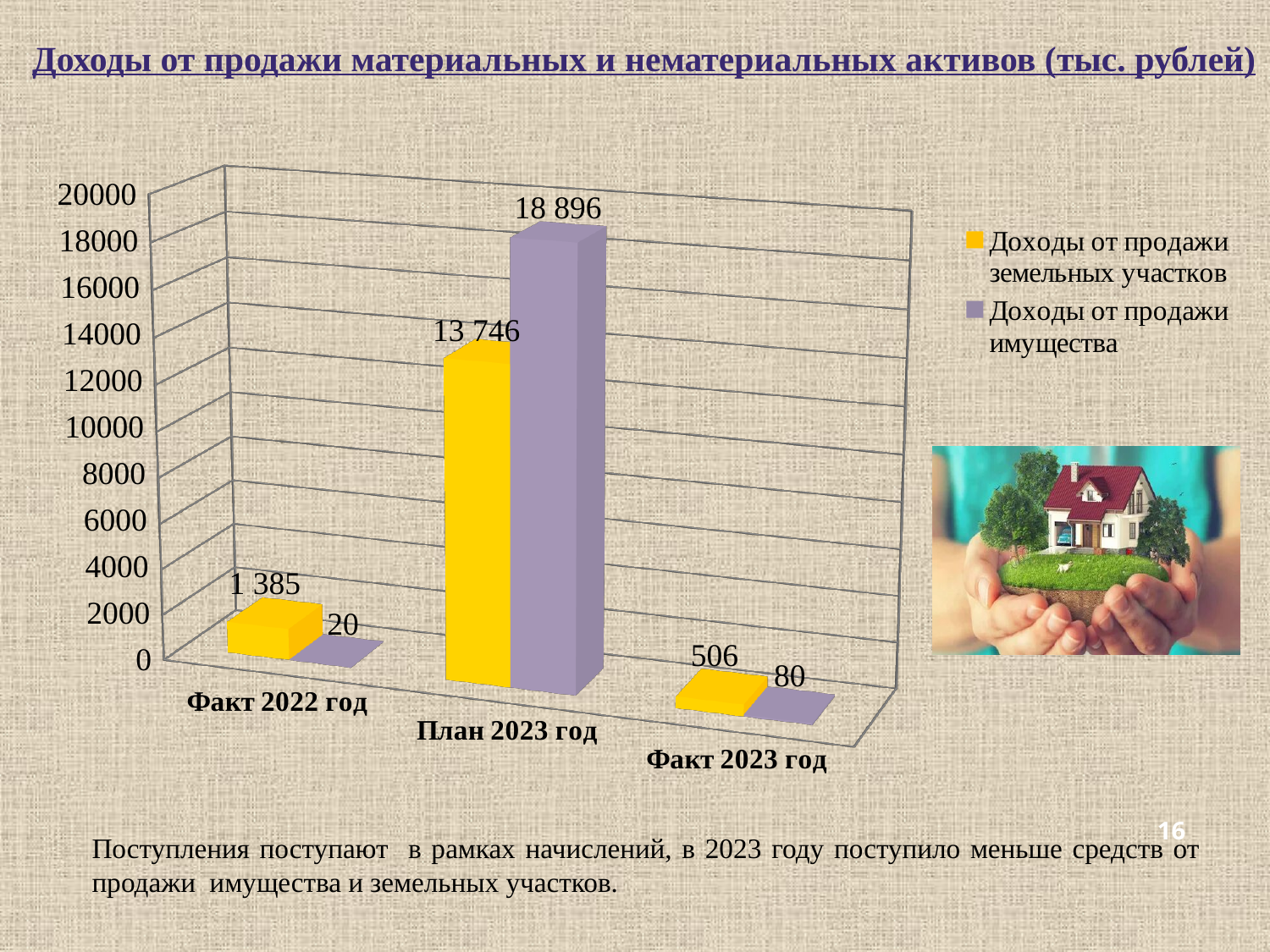
Which category has the lowest value for Доходы от продажи имущества? Факт 2022 год What is the value for Доходы от продажи имущества in План 2023 год? 18 896 What is the value for Доходы от продажи земельных участков in План 2023 год? 13 746 How many categories are shown on the x axis? 3 Which is larger in Факт 2023 год: Доходы от продажи земельных участков or Доходы от продажи имущества? Доходы от продажи земельных участков What is the difference between Доходы от продажи имущества and Доходы от продажи земельных участков in План 2023 год? 5 150 Which category has the highest value for Доходы от продажи имущества? План 2023 год What colour represents Доходы от продажи земельных участков in the legend? Yellow How many series does the legend list? 2 What is the value for Доходы от продажи имущества in Факт 2023 год? 80 What is the value for Доходы от продажи земельных участков in Факт 2022 год? 1 385 What kind of chart is shown on the slide? Bar chart